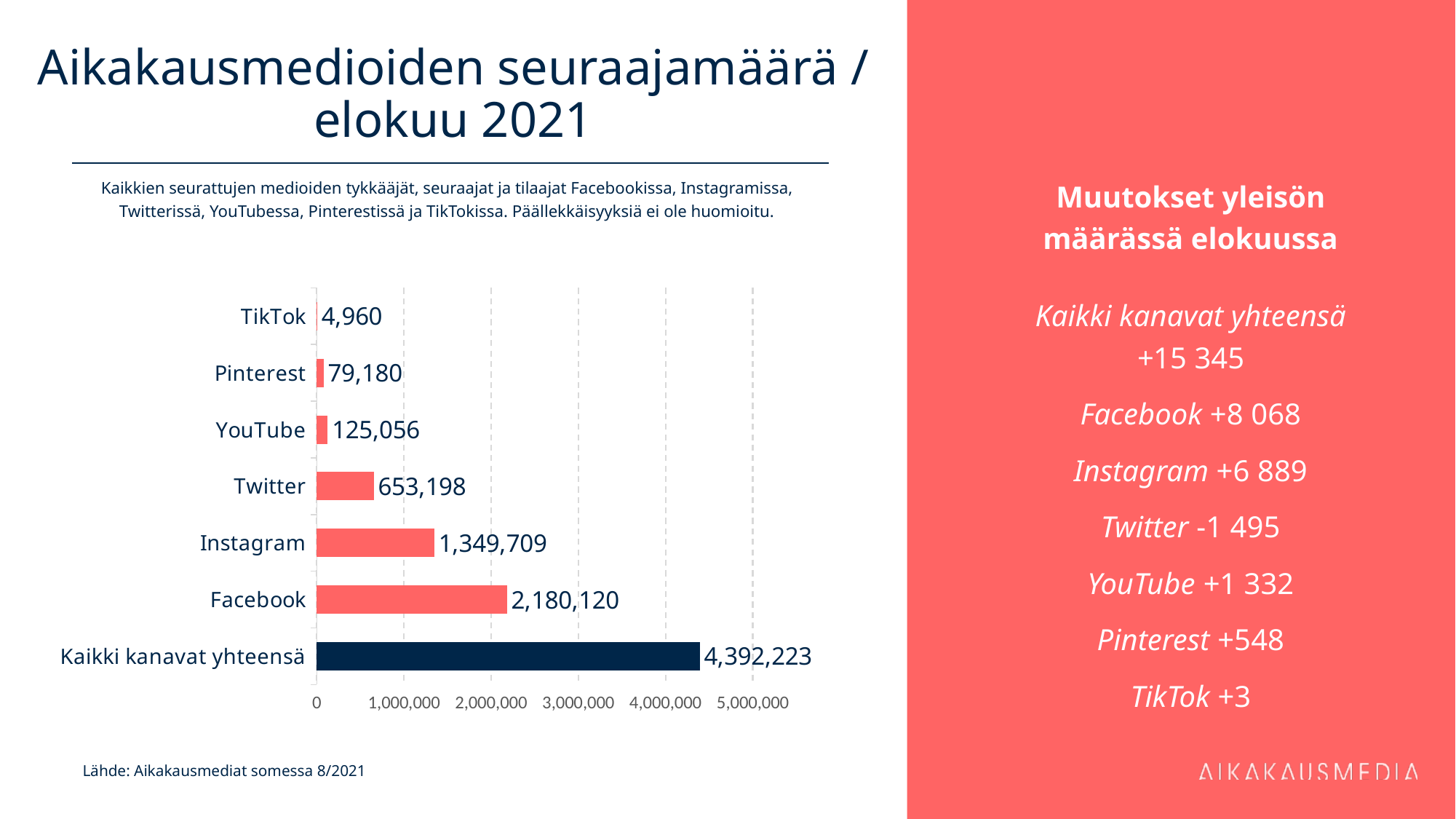
What is the value for Facebook? 2,180,120 Which is larger, the value for Twitter or the value for YouTube? Twitter What is the difference between the values for Facebook and Instagram? 830,411 Is the value for Instagram greater or less than 1,000,000? greater What kind of chart is shown on the slide? bar chart How many categories are shown on the chart? 7 What is the title of the slide containing the chart? Aikakausmedioiden seuraajamäärä / elokuu 2021 What is the value for Instagram? 1,349,709 What is the value for TikTok? 4,960 What is the value for Kaikki kanavat yhteensä? 4,392,223 Which individual channel (excluding the total bar) has the highest value? Facebook Which category has the lowest value? TikTok